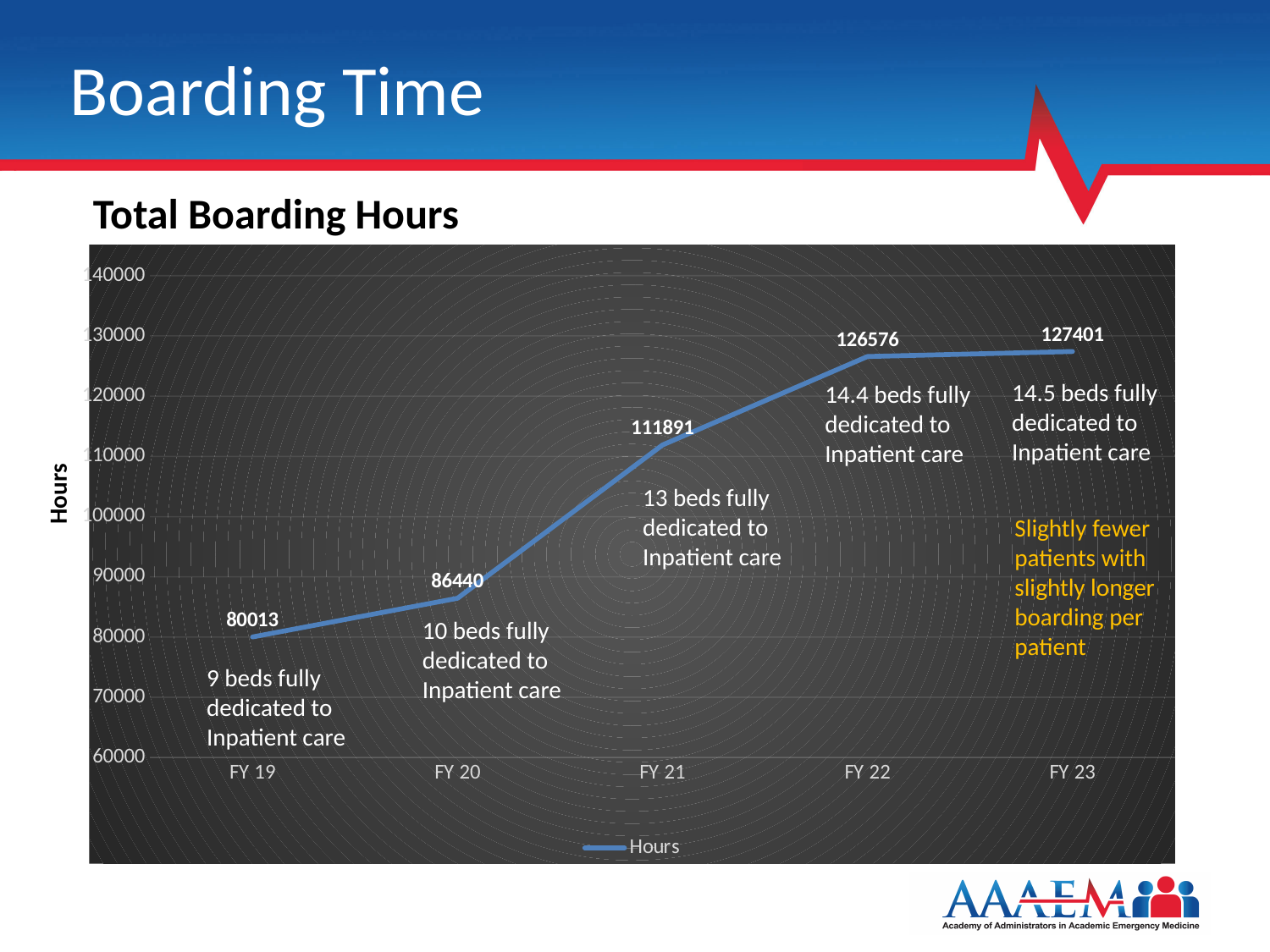
What is the value for FY 19? 80013 Do the values rise or fall from FY 19 to FY 23? rise What is the value for FY 23? 127401 Is the value for FY 22 greater or less than 120000? greater Which fiscal year has the highest total boarding hours? FY 23 What kind of chart is shown? line chart What is the value for FY 21? 111891 Which fiscal year has the lowest total boarding hours? FY 19 What is the difference between the values for FY 21 and FY 20? 25451 How many fiscal years are plotted on the x axis? 5 Which is larger, the value for FY 20 or the value for FY 21? FY 21 What is the difference between the values for FY 22 and FY 19? 46563